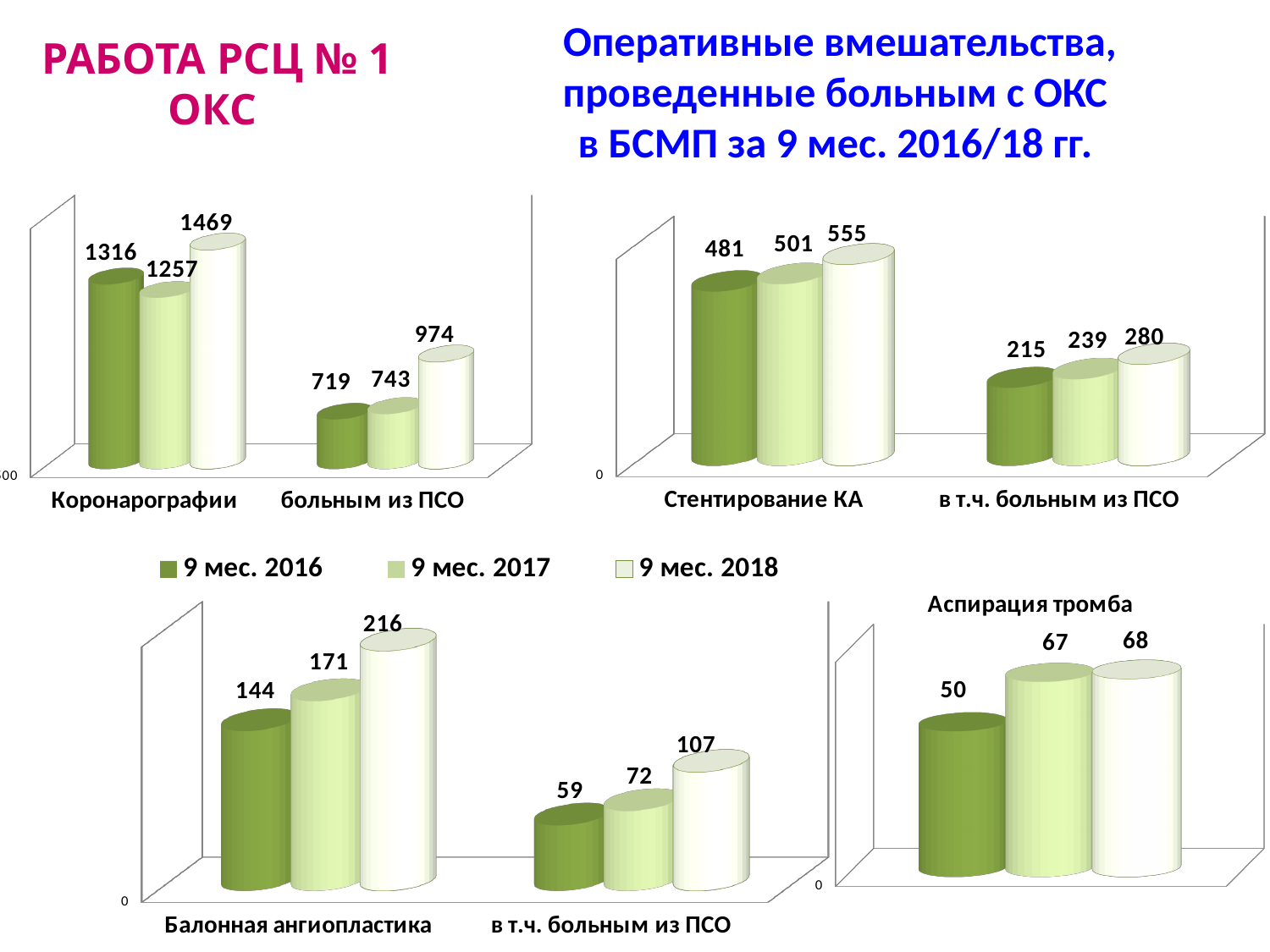
In the top-left chart, what is the value for Коронарографии in 9 мес. 2018? 1469 How many series does the legend list? 3 In the Аспирация тромба chart, what is the value for 9 мес. 2018? 68 In the top-right chart, what is the value for Стентирование КА in 9 мес. 2017? 501 In the top-left chart, what is the value for больным из ПСО in 9 мес. 2016? 719 What kind of chart is the bottom-left chart? bar chart In the top-right chart, what is the difference between the 9 мес. 2018 and 9 мес. 2016 values for в т.ч. больным из ПСО? 65 In the top-right chart, do the values for Стентирование КА rise or fall from 9 мес. 2016 to 9 мес. 2018? rise In the Аспирация тромба chart, which year has the lowest value? 9 мес. 2016 In the bottom-left chart, which year has the highest value for Балонная ангиопластика? 9 мес. 2018 In the bottom-left chart, what is the value for в т.ч. больным из ПСО in 9 мес. 2017? 72 In the top-left chart, is the value for Коронарографии in 9 мес. 2016 larger or smaller than in 9 мес. 2017? larger